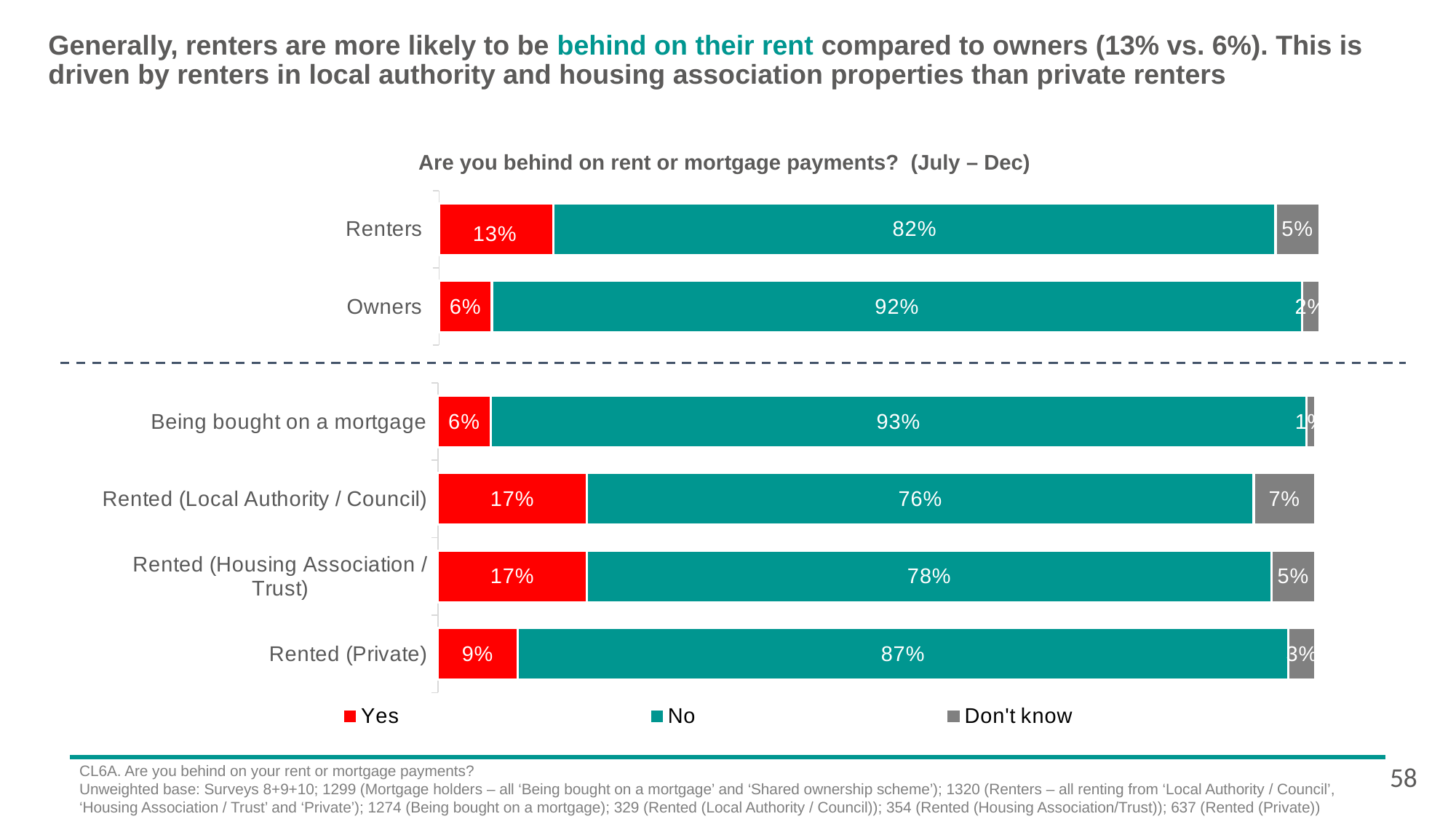
What is the 'No' value for Rented (Housing Association / Trust)? 78% What percentage of Renters answered 'Yes' to being behind on rent or mortgage payments? 13% What is the 'No' value for Owners? 92% What type of chart is shown? Stacked bar chart Which category has the lowest 'No' value? Rented (Local Authority / Council) Which has a larger 'Yes' value, Rented (Private) or Rented (Local Authority / Council)? Rented (Local Authority / Council) How many series does the legend list? 3 Which category has the highest 'No' value? Being bought on a mortgage How many categories are shown on the chart? 6 What is the 'Don't know' value for Rented (Local Authority / Council)? 7% Which colour represents the 'Yes' series in the legend? Red What is the difference between the 'Yes' values for Renters and Owners? 7 percentage points